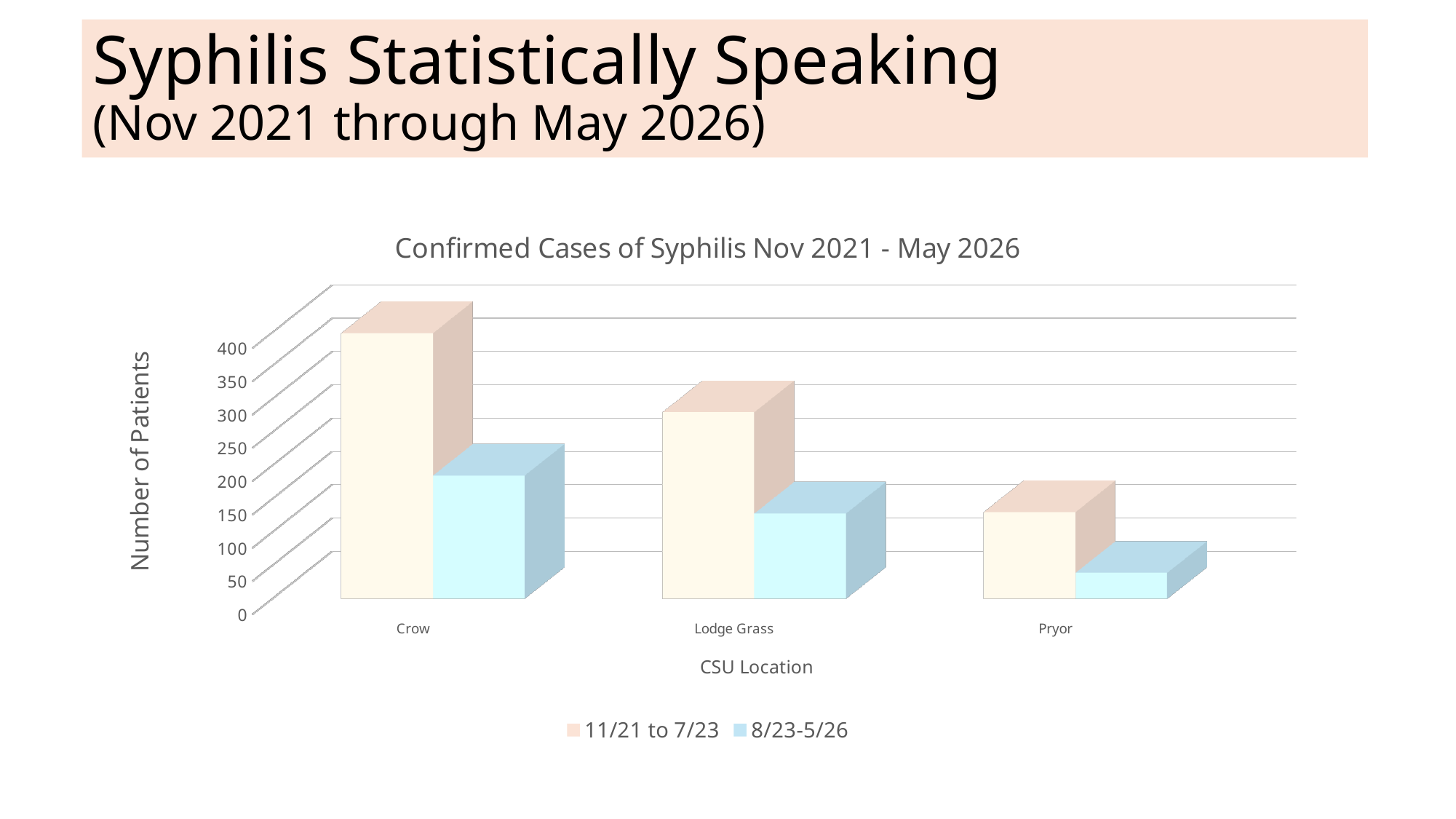
What kind of chart is shown on the slide? bar chart Which CSU location has the highest number of patients for 11/21 to 7/23? Crow Which CSU location has the lowest number of patients for 8/23-5/26? Pryor Do the values for the 8/23-5/26 series rise or fall from Crow to Pryor along the x axis? fall Is the value for Crow in the 11/21 to 7/23 series greater or less than 300? greater For the 11/21 to 7/23 series, which is larger: Crow or Lodge Grass? Crow Is the value for Pryor in the 8/23-5/26 series greater or less than 100? less How many series does the legend list? 2 Which CSU location has the lowest number of patients for 11/21 to 7/23? Pryor Is the value for Lodge Grass in the 11/21 to 7/23 series greater or less than 400? less How many CSU locations are shown on the x axis? 3